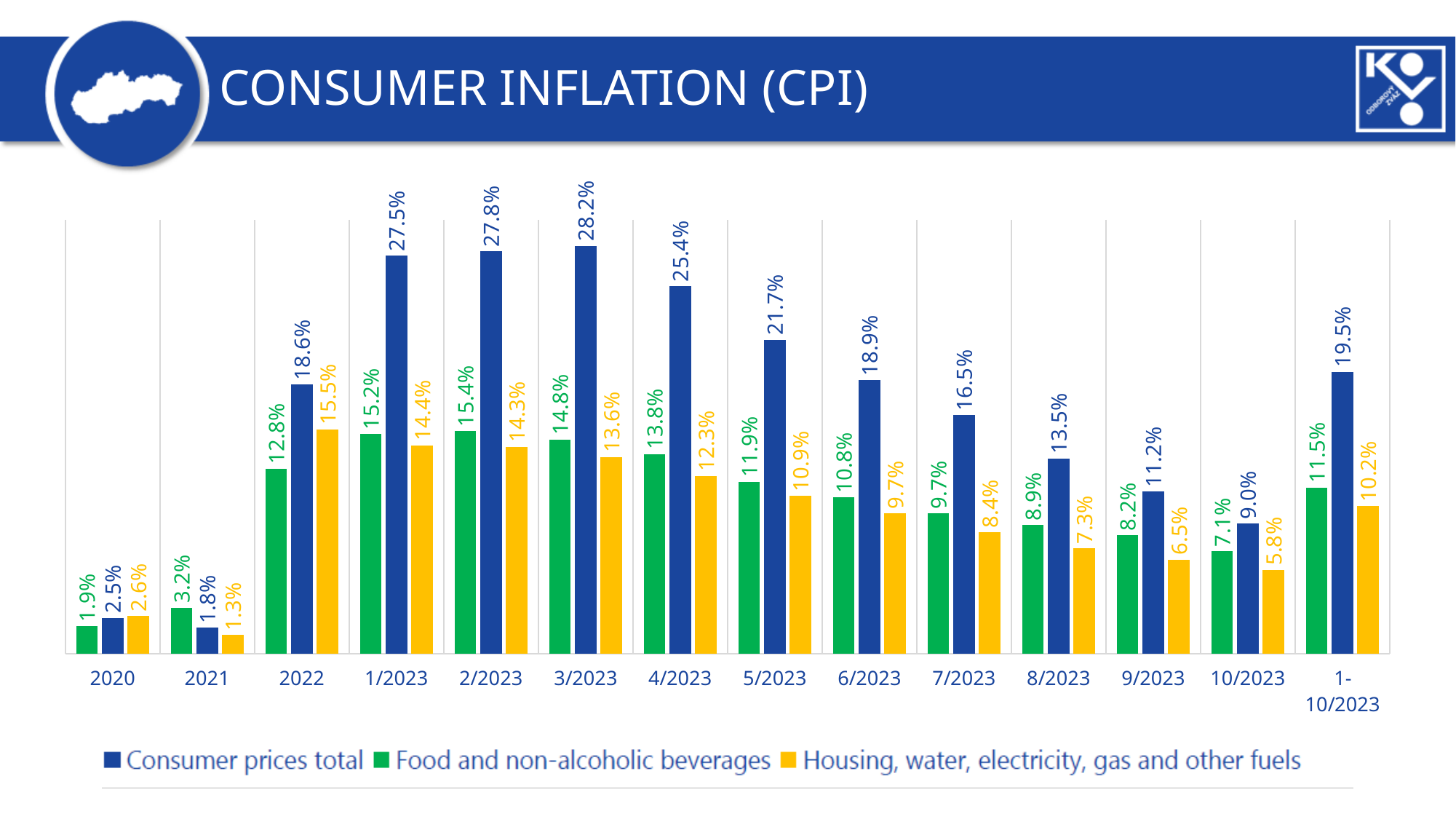
What is the value for Housing, water, electricity, gas and other fuels in 10/2023? 5.8% What is the value for Food and non-alcoholic beverages in 2022? 12.8% What is the value for Consumer prices total in 3/2023? 28.2% How many periods are shown on the x axis? 14 In which period is Consumer prices total highest? 3/2023 What is the difference between Consumer prices total and Food and non-alcoholic beverages in 1/2023? 12.3% How many series does the legend list? 3 Does Consumer prices total rise or fall from 3/2023 to 10/2023? Fall Which is larger in 2021: Food and non-alcoholic beverages or Consumer prices total? Food and non-alcoholic beverages What kind of chart is shown on the slide? Bar chart In which period is Housing, water, electricity, gas and other fuels lowest? 2021 What is the value for Consumer prices total in 1-10/2023? 19.5%